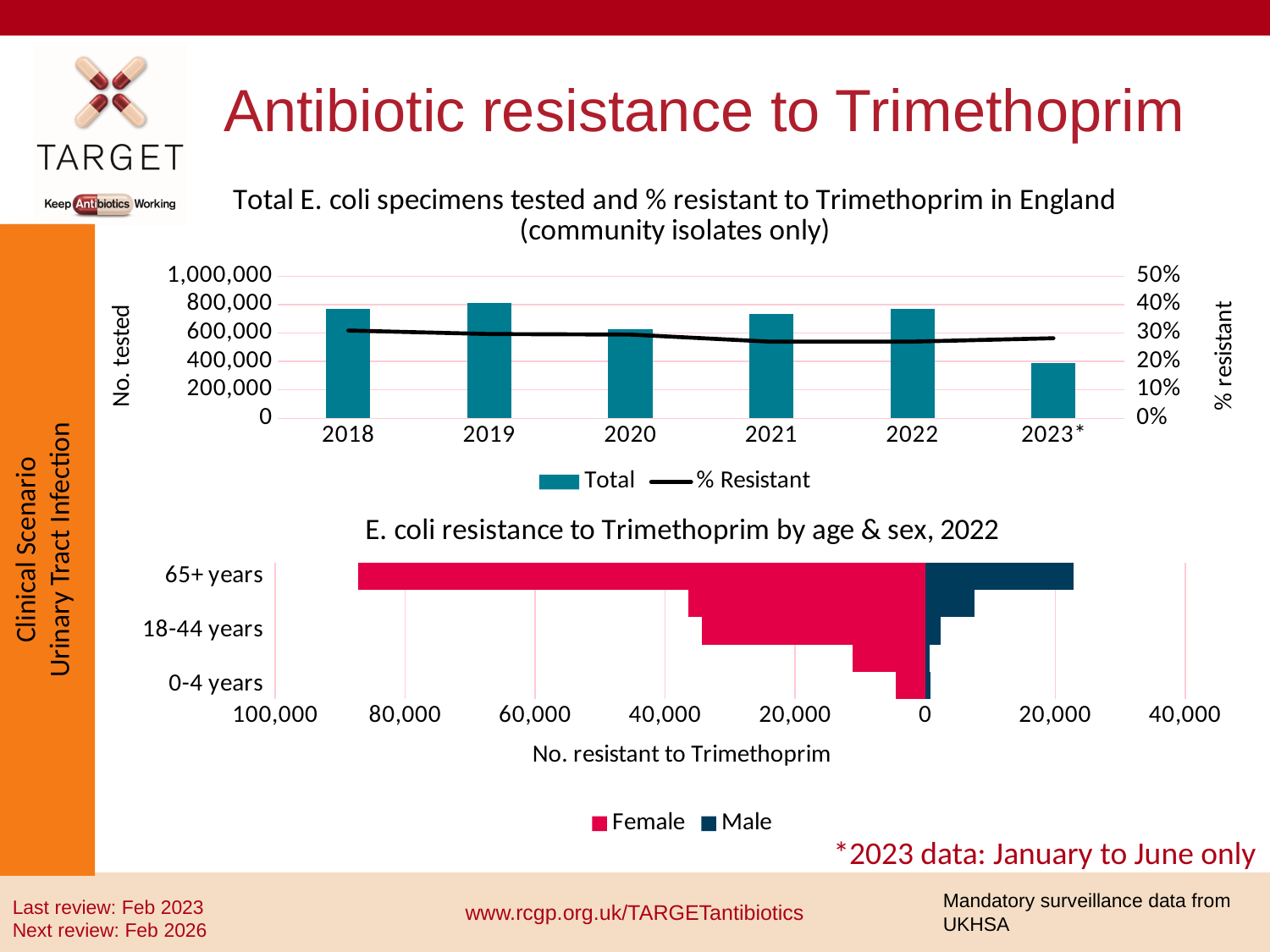
In the bottom chart, what is the x-axis title? No. resistant to Trimethoprim What kind of chart is the top chart titled 'Total E. coli specimens tested and % resistant to Trimethoprim in England'? A bar chart combined with a line chart In the top chart, how many series does the legend list? 2 In the top chart, which year has the lowest Total number tested? 2023* In the top chart, is the Total number tested for 2021 greater or less than 600,000? greater In the top chart, which year has the larger Total number tested, 2018 or 2020? 2018 In the bottom chart, is the number of resistant Female isolates in the 65+ years group greater or less than 80,000? greater In the top chart, how many years are shown on the x axis? 6 In the top chart, is the Total number tested for 2023* greater or less than 600,000? less In the top chart, which year has the highest Total number tested? 2019 In the bottom chart 'E. coli resistance to Trimethoprim by age & sex, 2022', which sex has more resistant isolates in the 65+ years group? Female In the top chart, does the % Resistant line rise or fall from 2018 to 2023*? It falls slightly